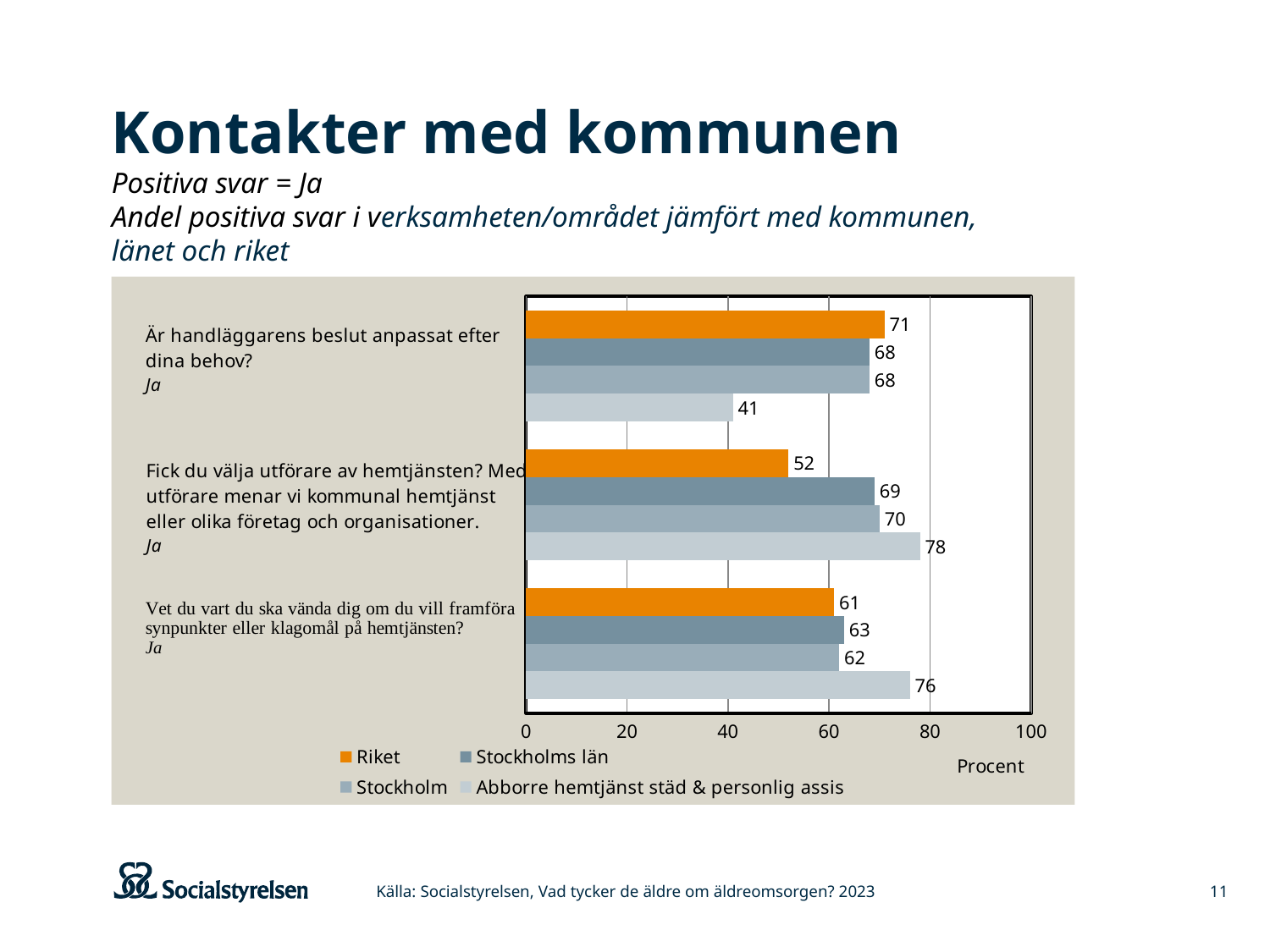
What is the value for Riket for the question "Är handläggarens beslut anpassat efter dina behov?"? 71 Which series has the highest value for the question "Fick du välja utförare av hemtjänsten?"? Abborre hemtjänst städ & personlig assis Which series has the lowest value for the question "Är handläggarens beslut anpassat efter dina behov?"? Abborre hemtjänst städ & personlig assis What kind of chart is shown on the slide? bar chart What is the value for Stockholms län for the question "Vet du vart du ska vända dig om du vill framföra synpunkter eller klagomål på hemtjänsten?"? 63 What is the value for Abborre hemtjänst städ & personlig assis for the question "Är handläggarens beslut anpassat efter dina behov?"? 41 What is the difference between the Abborre hemtjänst städ & personlig assis value and the Riket value for the question "Vet du vart du ska vända dig om du vill framföra synpunkter eller klagomål på hemtjänsten?"? 15 What is the value for Stockholm for the question "Fick du välja utförare av hemtjänsten?"? 70 For the question "Fick du välja utförare av hemtjänsten?", which is larger: the value for Riket or the value for Stockholms län? Stockholms län What label is shown on the horizontal axis of the chart? Procent How many question categories are plotted on the chart? 3 How many series does the legend list? 4